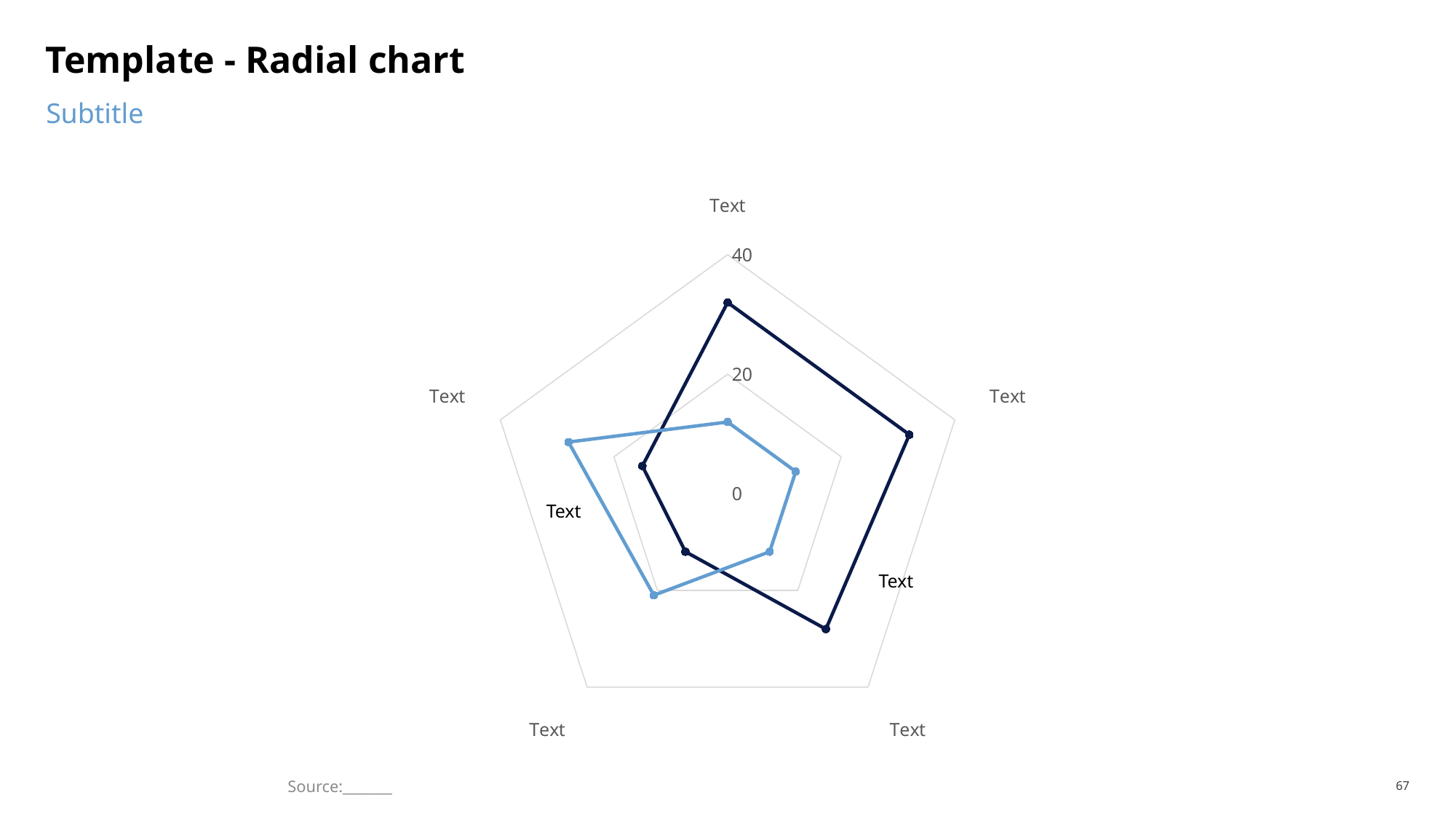
On the top axis of the radar chart, is the value of the light blue series greater or less than 20? less On the left axis of the radar chart, is the value of the light blue series greater or less than 20? greater On the top axis of the radar chart, is the value of the dark navy series greater or less than 20? greater What is the highest value shown on the radar chart's axis scale? 40 What is the title of the slide containing the radar chart? Template - Radial chart How many data series are plotted on the radar chart? 2 How many category axes does the radar chart have? 5 What kind of chart is shown on the slide? Radar chart On the left axis of the radar chart, which series has the larger value, the dark navy or the light blue? light blue On the top axis of the radar chart, which series has the larger value, the dark navy or the light blue? dark navy